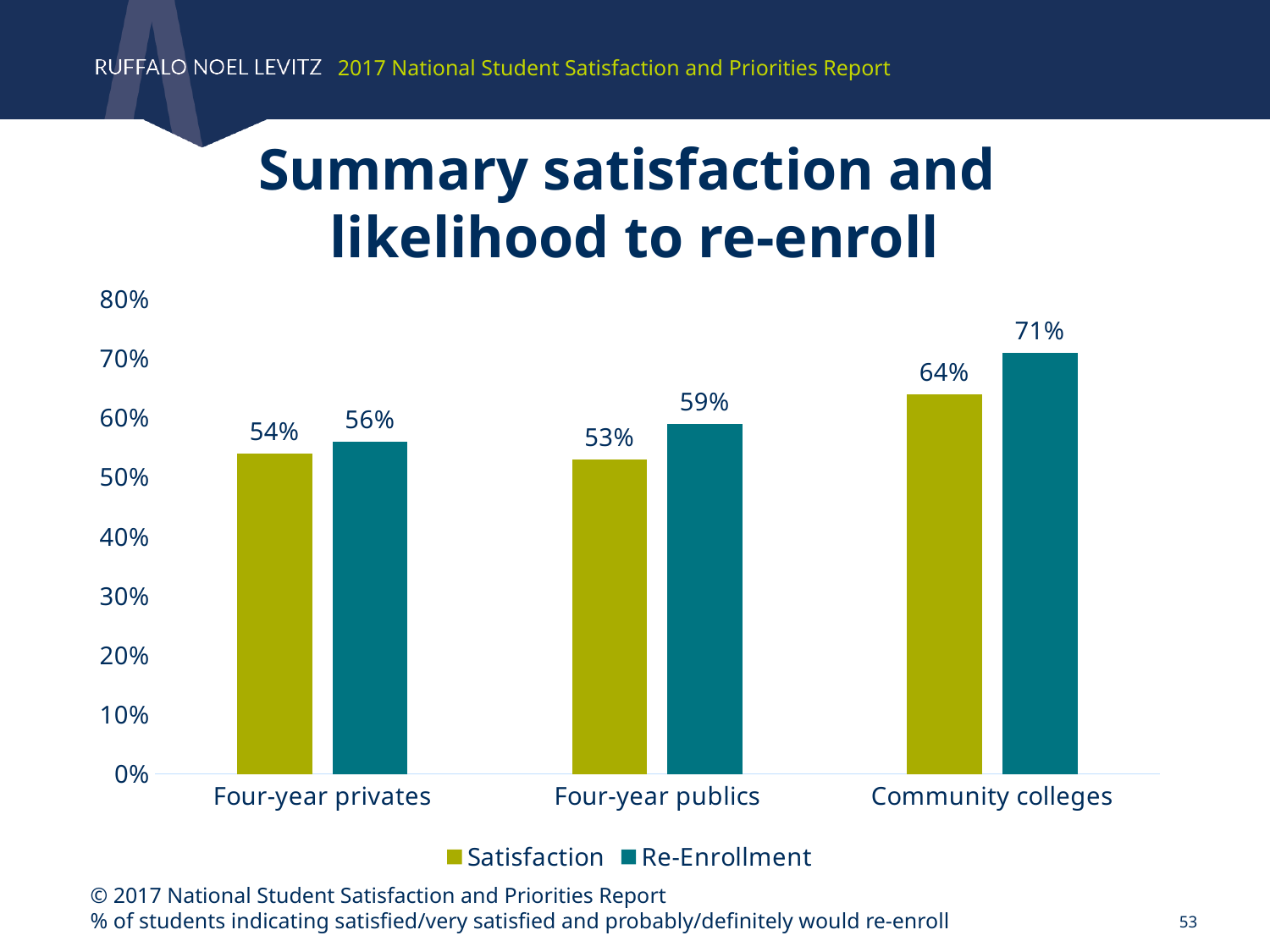
What is the Re-Enrollment value for Four-year publics? 59% Which category has the highest Satisfaction value? Community colleges Which category has the lowest Re-Enrollment value? Four-year privates What is the Re-Enrollment value for Community colleges? 71% Which is larger: the Satisfaction value for Four-year privates or the Satisfaction value for Community colleges? Community colleges How many categories are shown on the x axis? 3 Is the Re-Enrollment value for Community colleges greater or less than 70%? greater What is the Satisfaction value for Four-year privates? 54% What is the difference between the Re-Enrollment and Satisfaction values for Community colleges? 7% What are the two series named in the legend? Satisfaction and Re-Enrollment What kind of chart is shown on the slide? Bar chart How many series does the legend list? 2